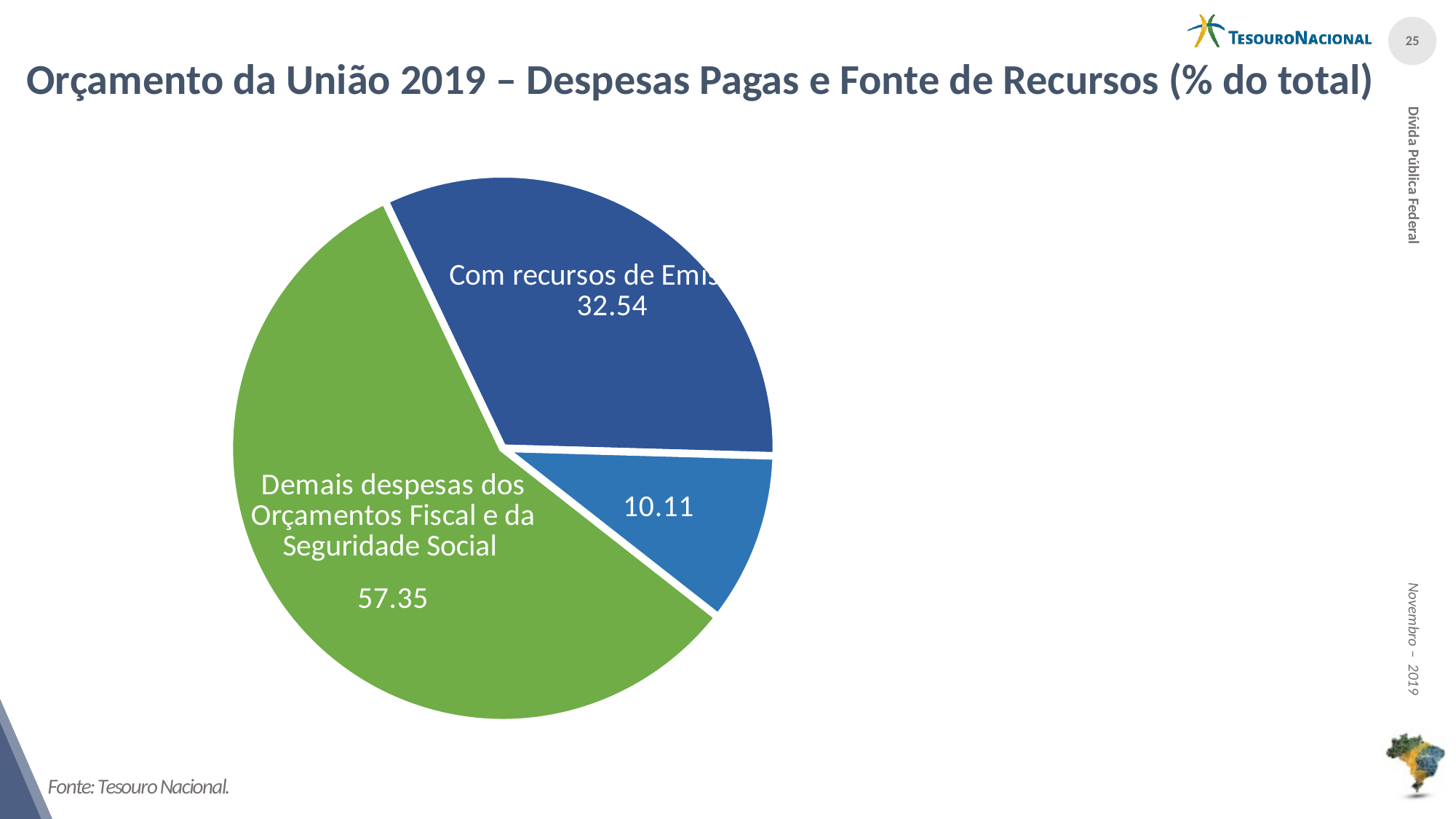
What is the title of the slide containing the pie chart? Orçamento da União 2019 – Despesas Pagas e Fonte de Recursos (% do total) What is the total of the three values shown on the pie chart? 100 How many slices does the pie chart have? 3 What is the value shown on the light blue slice of the pie chart? 10.11 What kind of chart is shown on the slide? Pie chart What is the difference between the value of the dark blue slice and the value of the light blue slice? 22.43 What is the value shown on the dark blue slice of the pie chart? 32.54 Which slice of the pie chart is the largest? Demais despesas dos Orçamentos Fiscal e da Seguridade Social Which is larger: the green slice or the dark blue slice? The green slice What is the value shown for the slice labelled 'Demais despesas dos Orçamentos Fiscal e da Seguridade Social'? 57.35 Which slice of the pie chart is the smallest? The light blue slice (10.11) What is the difference between the value of the green slice and the value of the dark blue slice? 24.81